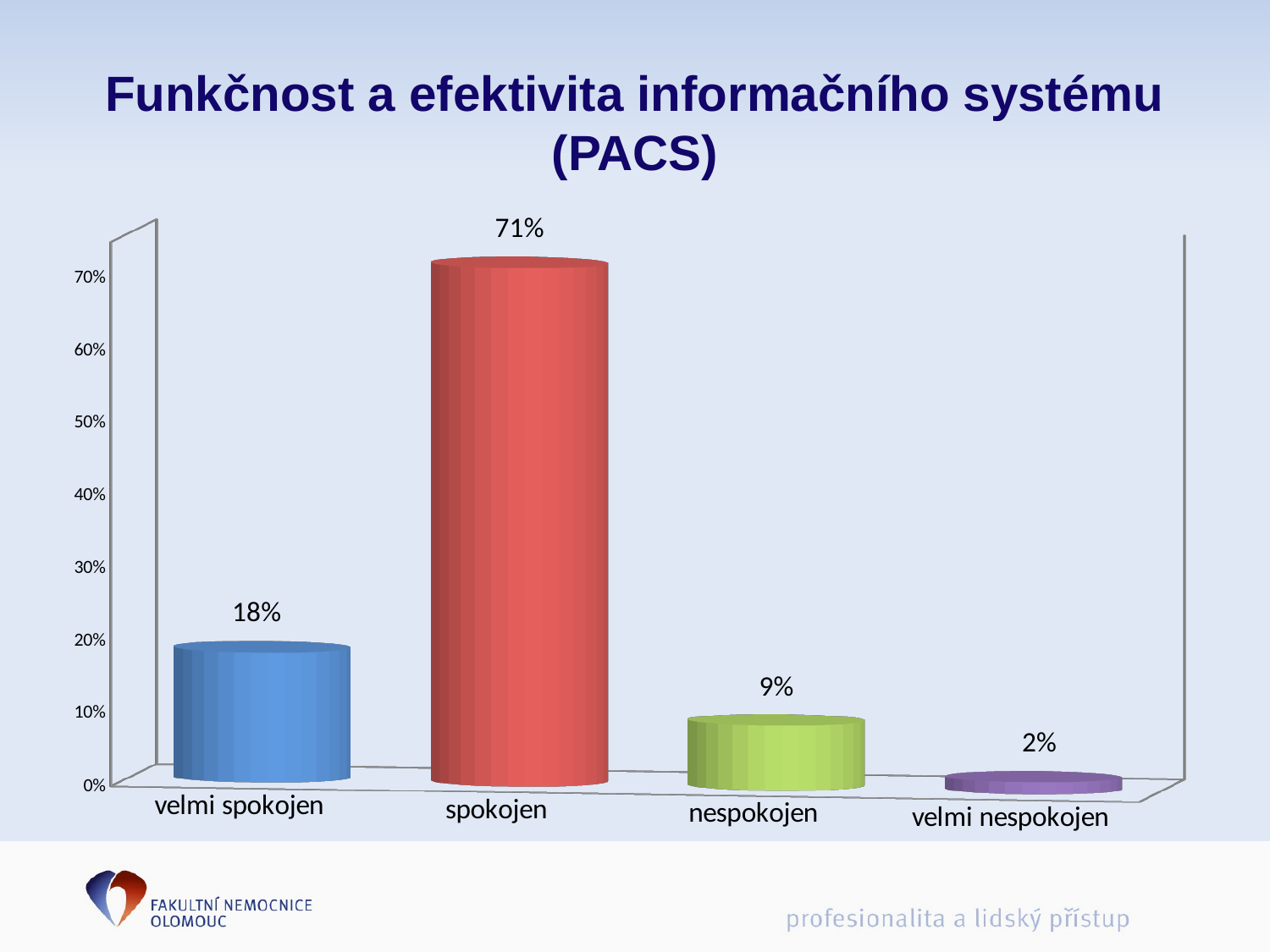
Is the value for "velmi spokojen" greater or less than 20%? less What is the value for "velmi spokojen"? 18% What kind of chart is shown on the slide? bar chart What is the difference between the values for "spokojen" and "velmi spokojen"? 53% What is the value for "nespokojen"? 9% Which category has the highest value? spokojen Which is larger, the value for "velmi spokojen" or the value for "nespokojen"? velmi spokojen What is the value for "spokojen"? 71% What is the value for "velmi nespokojen"? 2% How many categories are shown on the x axis? 4 What is the title of the chart? Funkčnost a efektivita informačního systému (PACS) Which category has the lowest value? velmi nespokojen